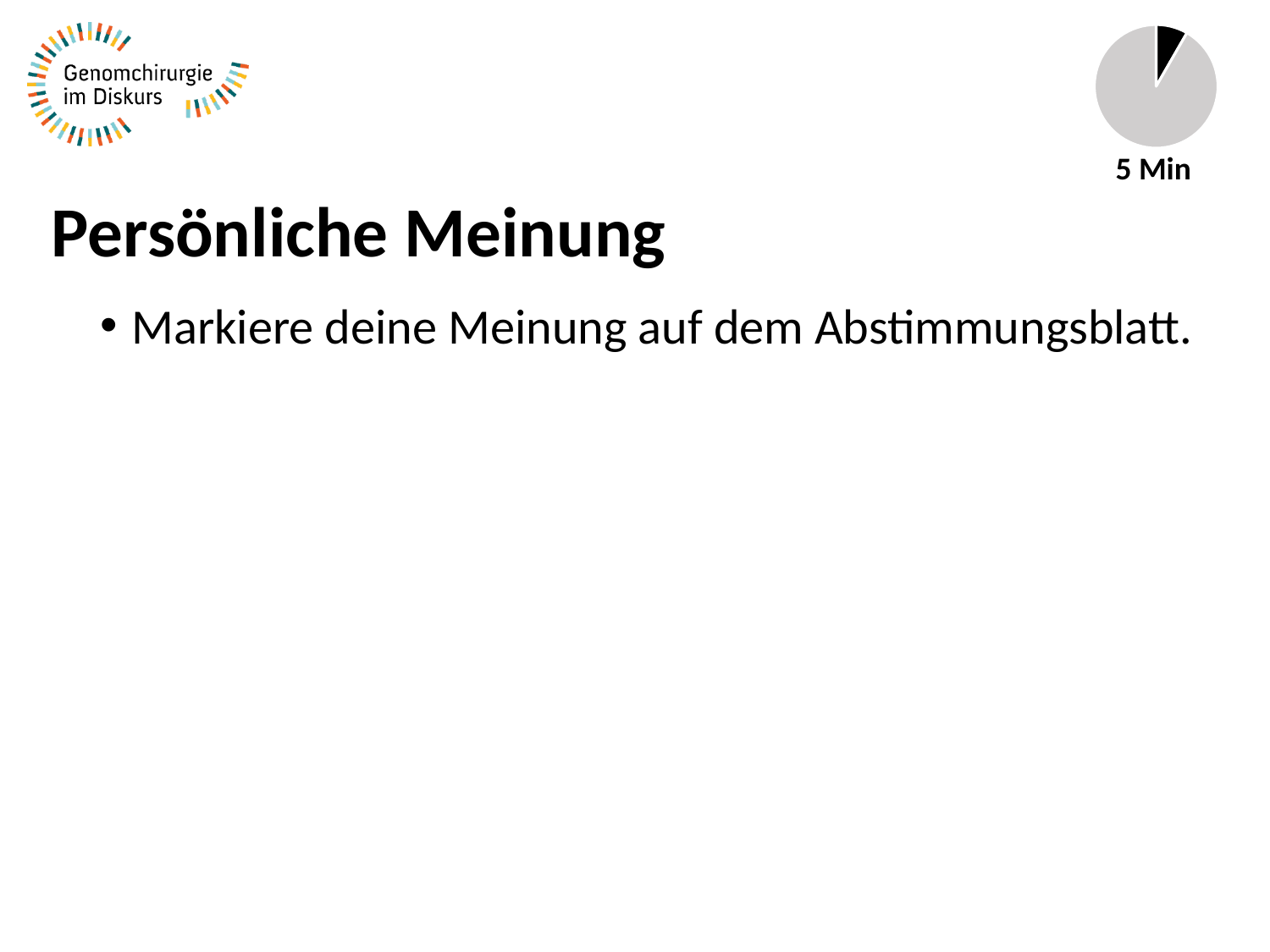
How many slices does the pie chart in the top right corner have? 2 In the pie chart in the top right corner, which slice is larger, the black one or the grey one? the grey one What colour is the smaller slice of the pie chart in the top right corner? black What label is printed below the pie chart in the top right corner? 5 Min What kind of chart is shown in the top right corner of the slide? pie chart